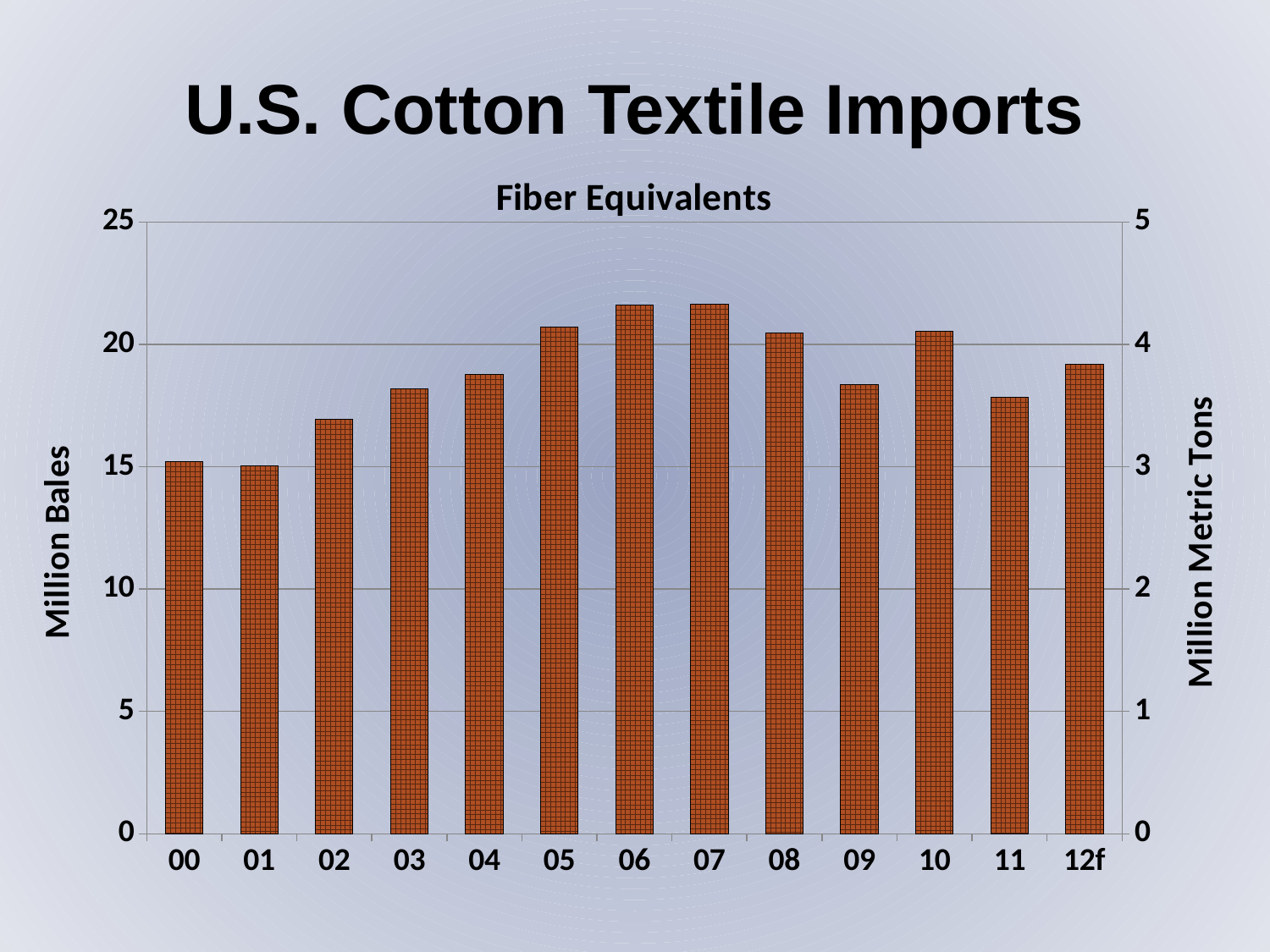
How many years (categories) are plotted on the x axis? 13 What is the label on the left vertical axis? Million Bales Is the value for 11 greater or less than 20 million bales? less What kind of chart is shown on the slide? bar chart Is the value for 03 greater or less than 15 million bales? greater Which year has the larger value, 10 or 11? 10 Is the value for 12f greater or less than 20 million bales? less Do the values rise or fall from 00 to 07? rise Which year has the larger value, 05 or 02? 05 What is the label on the right vertical axis? Million Metric Tons